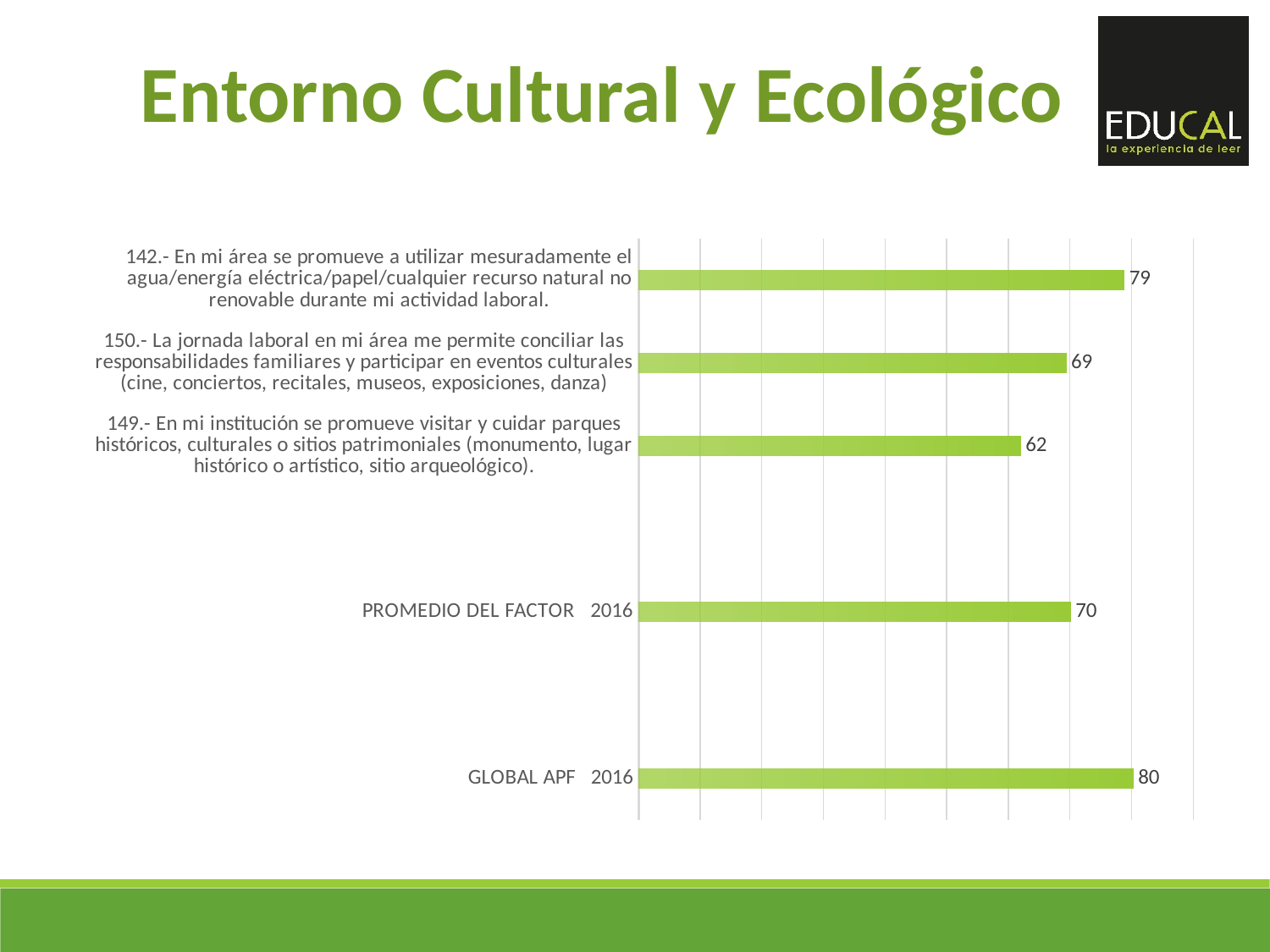
Which bar has the lowest value? 149.- En mi institución se promueve visitar y cuidar parques históricos, culturales o sitios patrimoniales What kind of chart is shown on the slide? Bar chart What is the difference between GLOBAL APF 2016 and PROMEDIO DEL FACTOR 2016? 10 What is the difference between the value for item 142 and the value for item 149? 17 How many bars are plotted in the chart? 5 What value is shown for item 150 (work schedule allows family responsibilities and cultural events)? 69 What value is shown for item 149 (promoting visiting and caring for historic parks and heritage sites)? 62 What is the value of PROMEDIO DEL FACTOR 2016? 70 What is the value of GLOBAL APF 2016? 80 Which is larger, the value for item 150 or PROMEDIO DEL FACTOR 2016? PROMEDIO DEL FACTOR 2016 Which bar has the highest value? GLOBAL APF 2016 What value is shown for item 142 (promoting measured use of water/electricity/paper)? 79